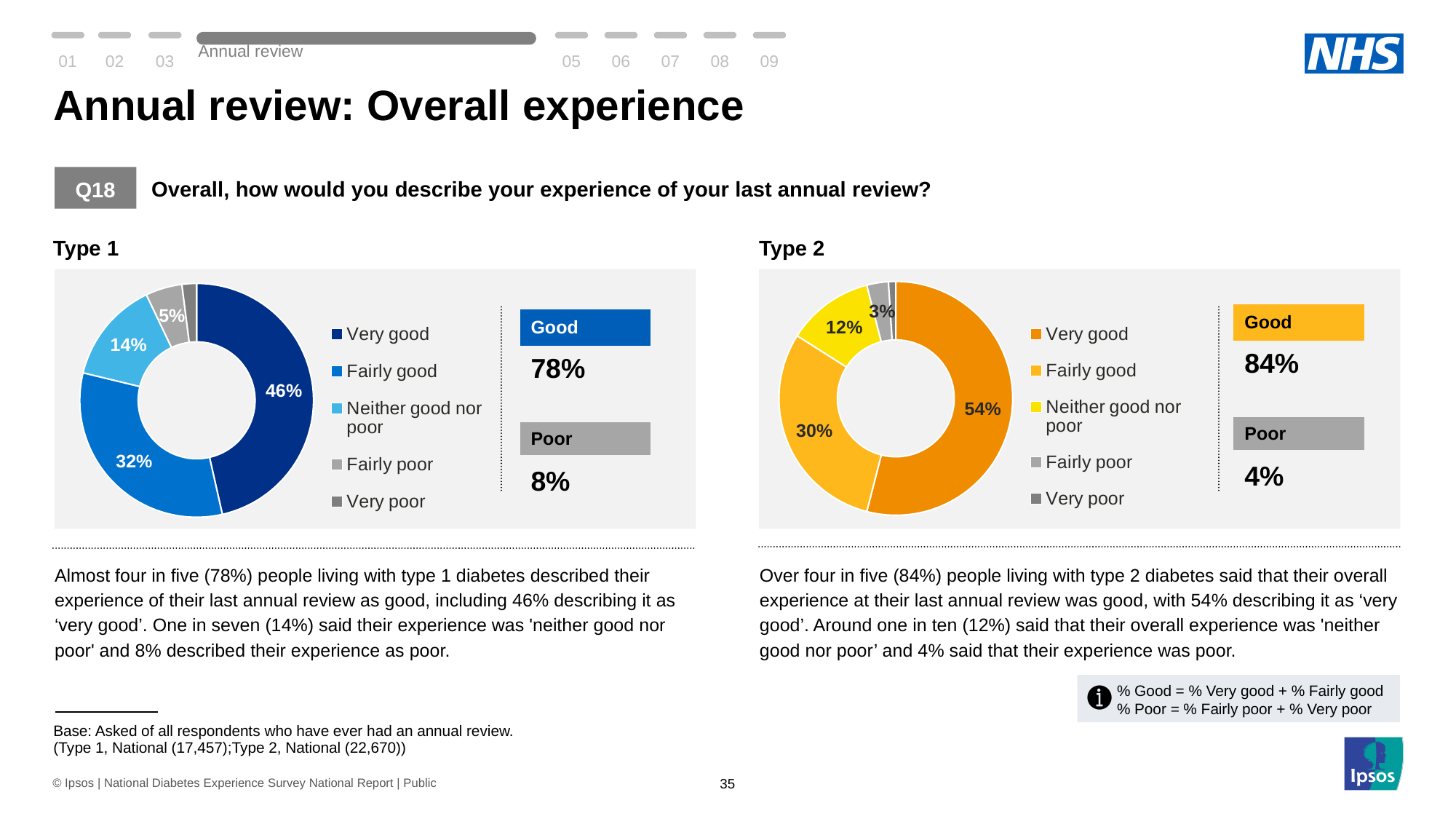
How many categories does the legend of the Type 1 chart list? 5 What is the combined 'Good' percentage shown for Type 2? 84% What kind of chart is used for Type 1? Donut (pie) chart In the Type 2 chart, what percentage said 'Fairly poor'? 3% In the Type 1 chart, which category has the smallest share? Very poor In the Type 2 chart, which category has the largest share? Very good In the Type 2 chart, what percentage of respondents described their experience as 'Fairly good'? 30% What is the combined 'Poor' percentage shown for Type 1? 8% Which is larger: the 'Very good' share in the Type 1 chart or the 'Very good' share in the Type 2 chart? Type 2 In the Type 1 chart, what percentage said 'Neither good nor poor'? 14% In the Type 1 chart, what percentage of respondents described their experience as 'Very good'? 46% In the Type 1 chart, what is the difference in percentage points between 'Very good' and 'Fairly good'? 14